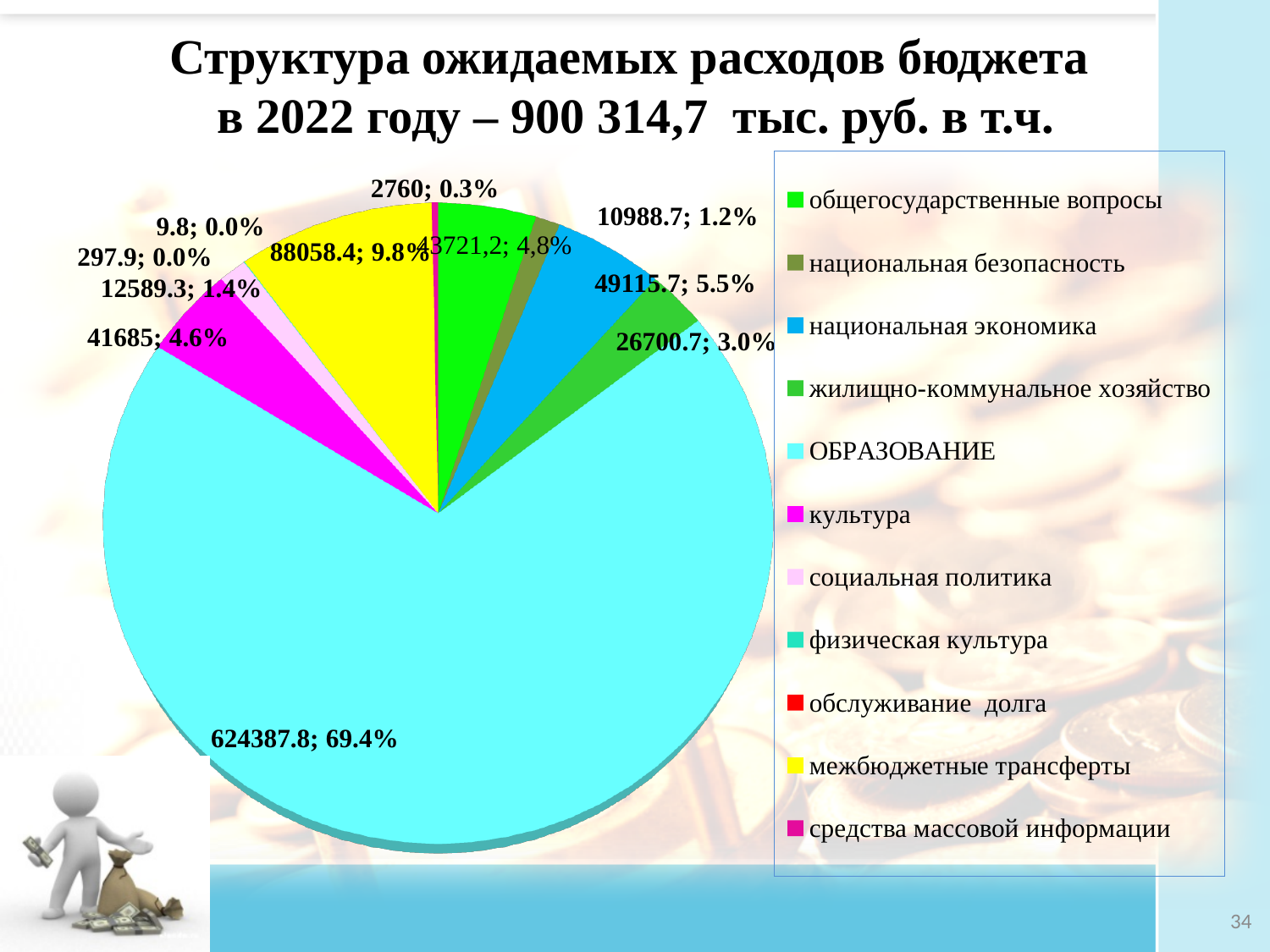
Which category has the largest slice of the pie chart? ОБРАЗОВАНИЕ What share of the pie does жилищно-коммунальное хозяйство account for? 3.0% What kind of chart is shown on the slide? pie chart What share of the pie does ОБРАЗОВАНИЕ account for? 69.4% What value is shown for культура? 41685 What value is shown for межбюджетные трансферты? 88058.4 Which is larger, the slice for национальная экономика or the slice for культура? национальная экономика What share of the pie does национальная экономика account for? 5.5% What is the difference between the values for национальная экономика (49115.7) and культура (41685)? 7430.7 According to the slide title, what is the total expected budget expenditure in 2022? 900 314,7 тыс. руб. What value is shown for ОБРАЗОВАНИЕ? 624387.8 How many categories does the legend of the pie chart list? 11